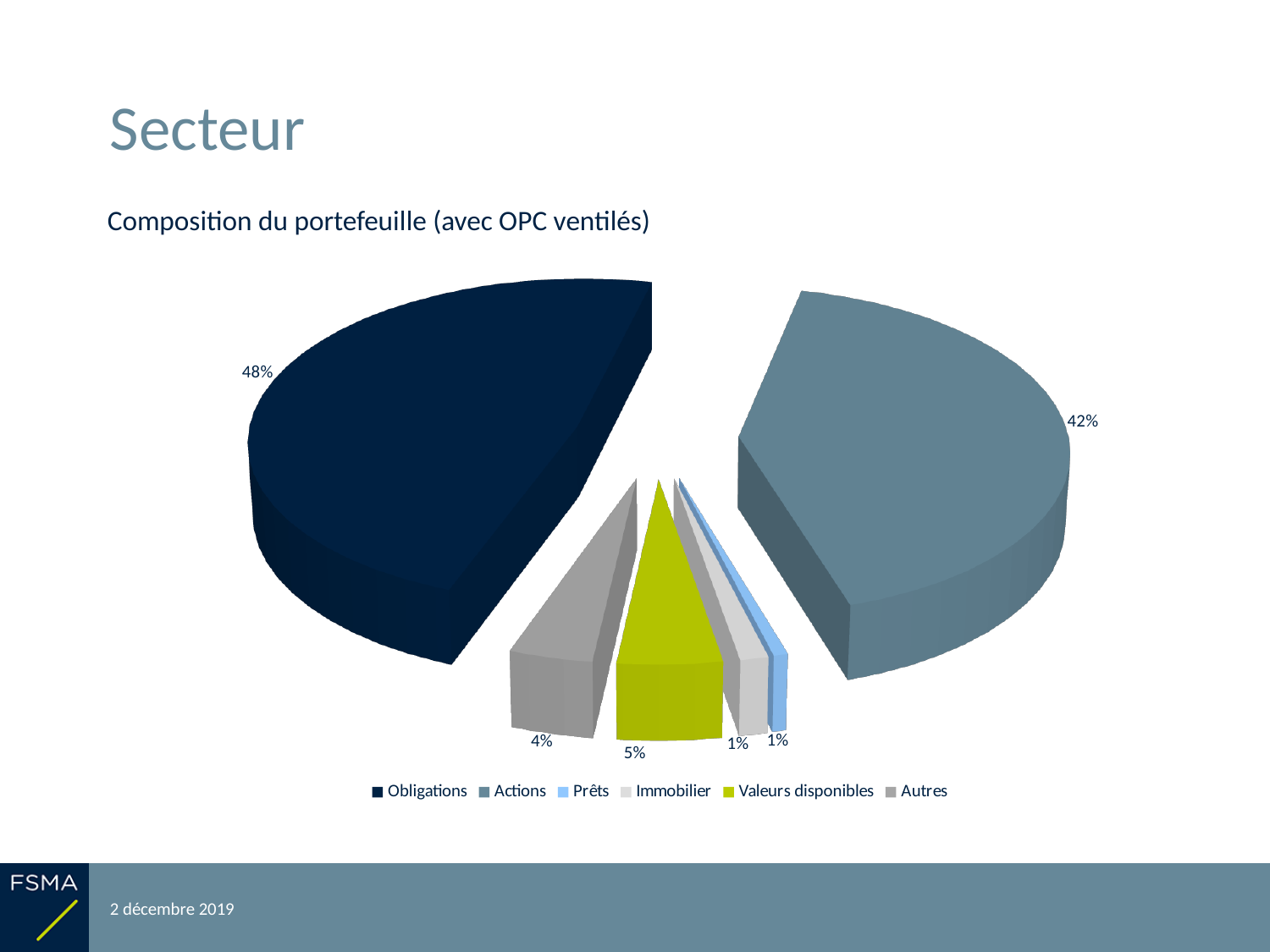
Which category has the largest share of the portfolio? Obligations What colour is the Valeurs disponibles slice? yellow-green What percentage is shown for Autres? 4% What percentage is shown for Immobilier? 1% How many categories does the legend list? 6 What share of the portfolio is Obligations? 48% What is the title of the chart? Composition du portefeuille (avec OPC ventilés) What share of the portfolio is Actions? 42% What is the difference in percentage points between Obligations and Actions? 6 What type of chart is shown on the slide? pie chart Which is larger, the share for Valeurs disponibles or the share for Autres? Valeurs disponibles What percentage is shown for Valeurs disponibles? 5%